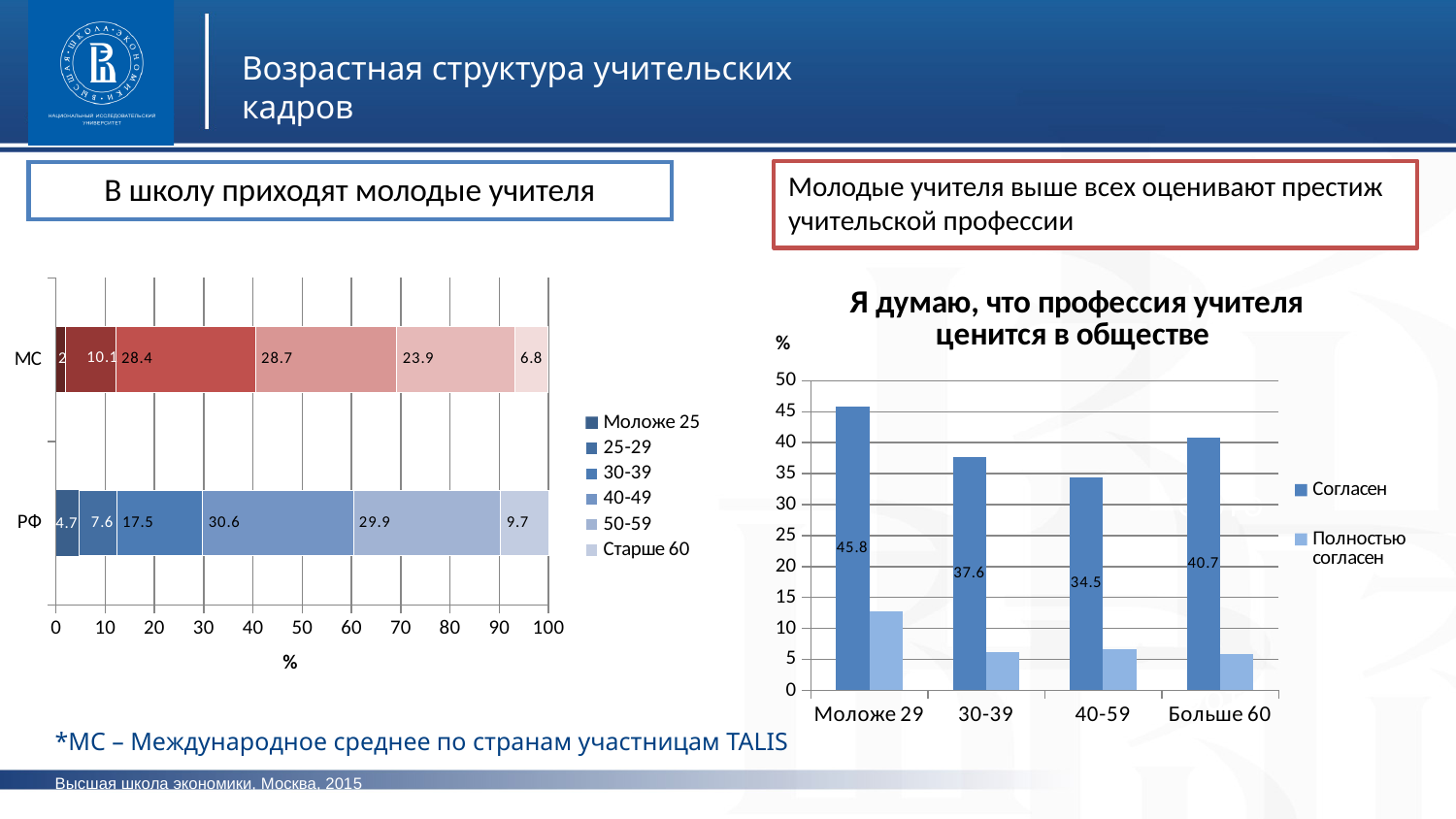
In the chart 'Я думаю, что профессия учителя ценится в обществе', is the Полностью согласен value for Моложе 29 greater or less than 10? greater In the left chart, what is the difference between the 30-39 values for МС and РФ? 10.9 In the chart 'Я думаю, что профессия учителя ценится в обществе', what is the difference between the Согласен values for Моложе 29 and 40-59? 11.3 In the left chart, which is larger: the 25-29 value for МС or for РФ? МС What kind of chart is the left chart? Stacked bar chart In the left chart, what is the value for the 30-39 age group for МС? 28.4 In the chart 'Я думаю, что профессия учителя ценится в обществе', what is the Согласен value for Моложе 29? 45.8 In the left chart, what is the value for the 40-49 age group for РФ? 30.6 In the chart 'Я думаю, что профессия учителя ценится в обществе', which category has the lowest Согласен value? 40-59 How many categories are shown on the x axis of the chart 'Я думаю, что профессия учителя ценится в обществе'? 4 In the left chart, what is the value for the Старше 60 group for РФ? 9.7 How many series does the legend of the left chart list? 6